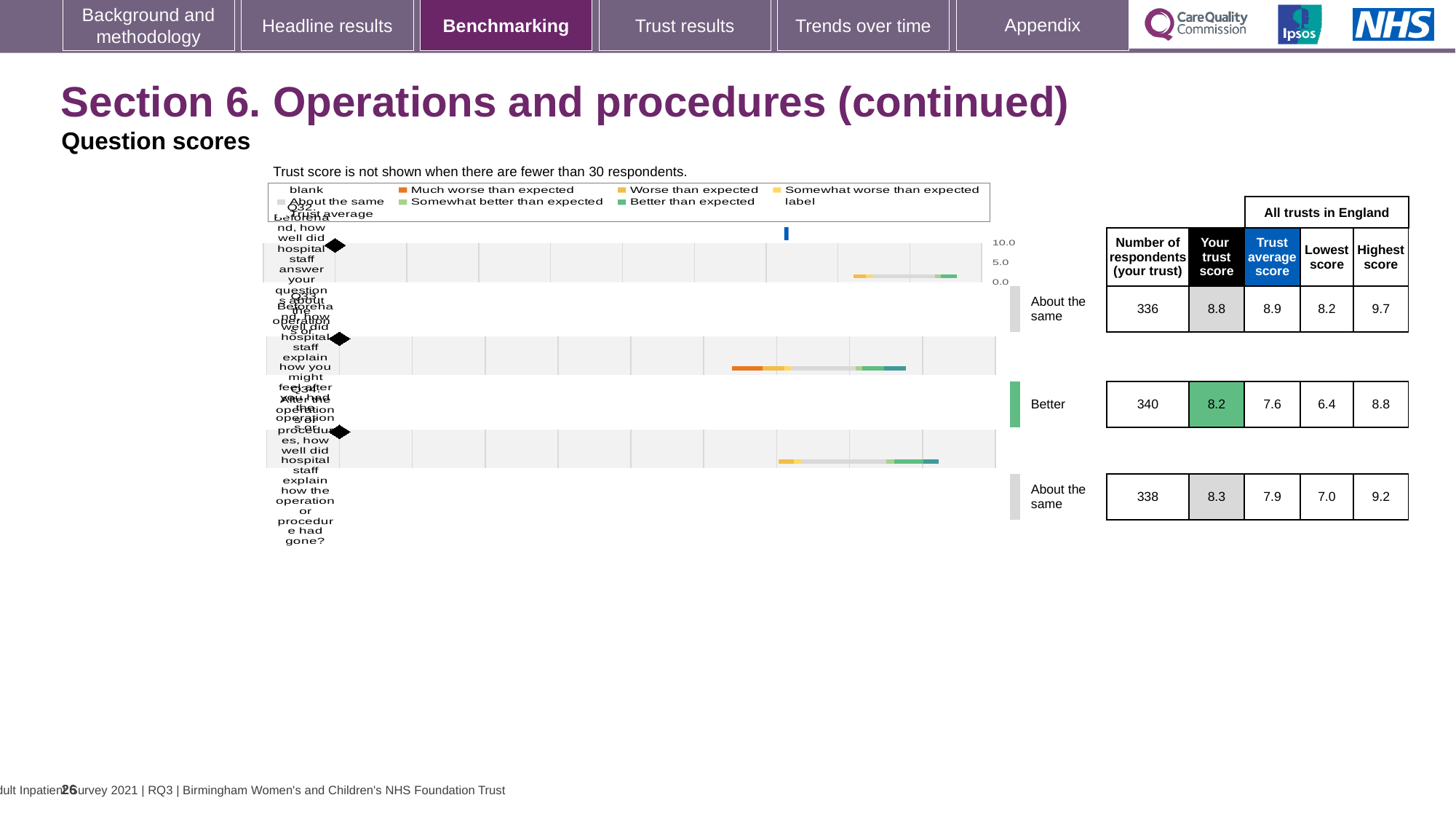
How many question rows are shown in the chart? 3 What is the trust average score for all trusts in England for the second question row? 7.6 What is the 'Your trust score' for the third question row (About the same, 338 respondents)? 8.3 What is the highest score across all trusts in England for the first question row? 9.7 What is the 'Your trust score' for the second question row (Better, 340 respondents)? 8.2 What is the difference between the trust score and the trust average score for the second question row? 0.6 Which question row has the lowest 'Your trust score'? The second row (8.2) Is the trust score for the third question row larger or smaller than the trust average score for that row? Larger What is the 'Your trust score' for the first question row (About the same, 336 respondents)? 8.8 How many respondents does the second question row have? 340 What is the lowest score across all trusts in England for the third question row? 7.0 Which question row has the highest 'Your trust score'? The first row (8.8)